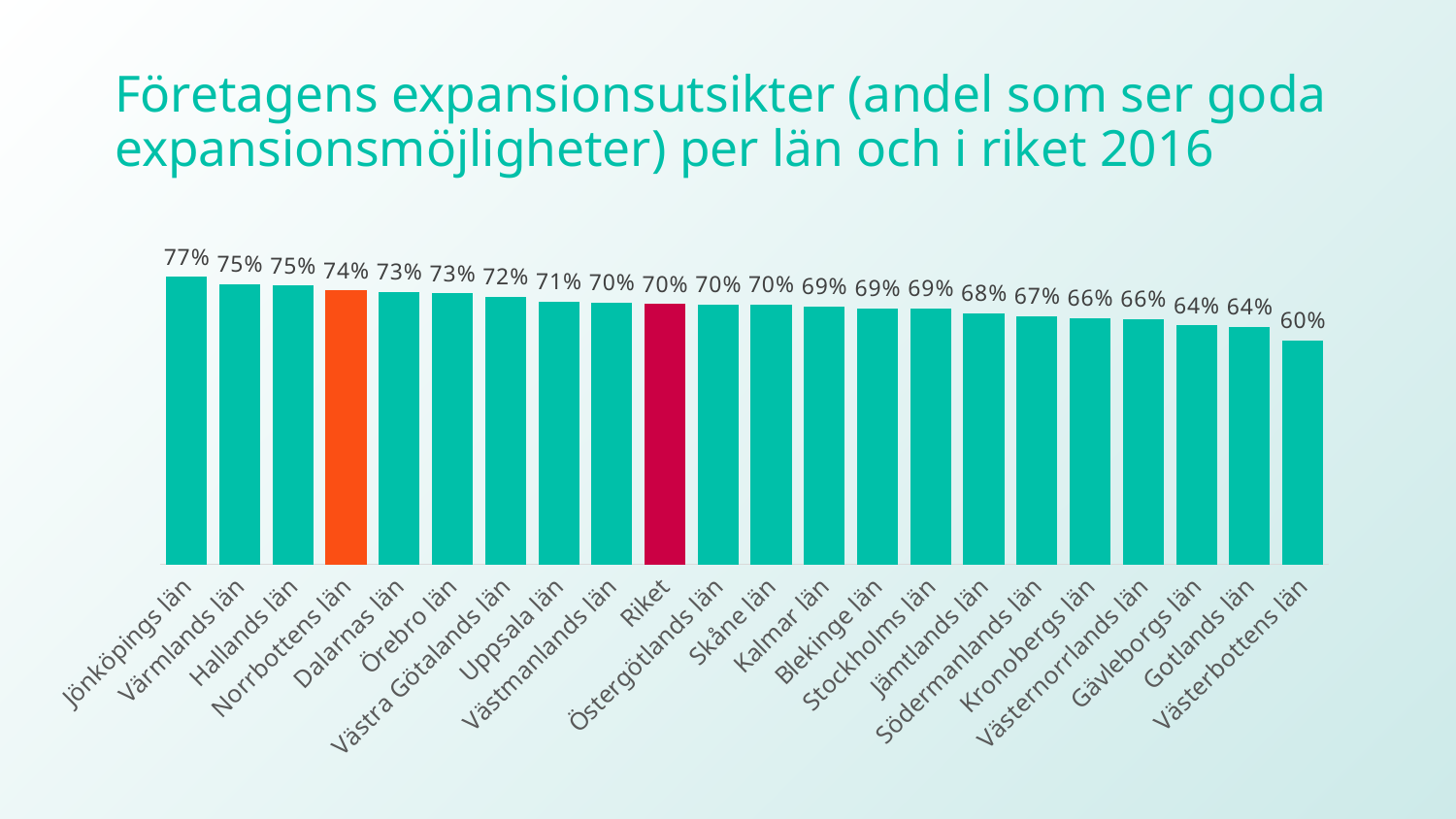
What is the value for Jönköpings län? 77% Which category has the highest value? Jönköpings län What is the value for Norrbottens län? 74% What is the difference between the values for Jönköpings län and Västerbottens län? 17% How many bars are shown in the chart? 22 Which category has the lowest value? Västerbottens län What is the difference between the values for Norrbottens län and Riket? 4% What kind of chart is shown on the slide? Bar chart What is the value for Riket? 70% Which is larger, the value for Uppsala län or the value for Gotlands län? Uppsala län Do the values rise or fall from left to right along the x axis? Fall What is the value for Stockholms län? 69%